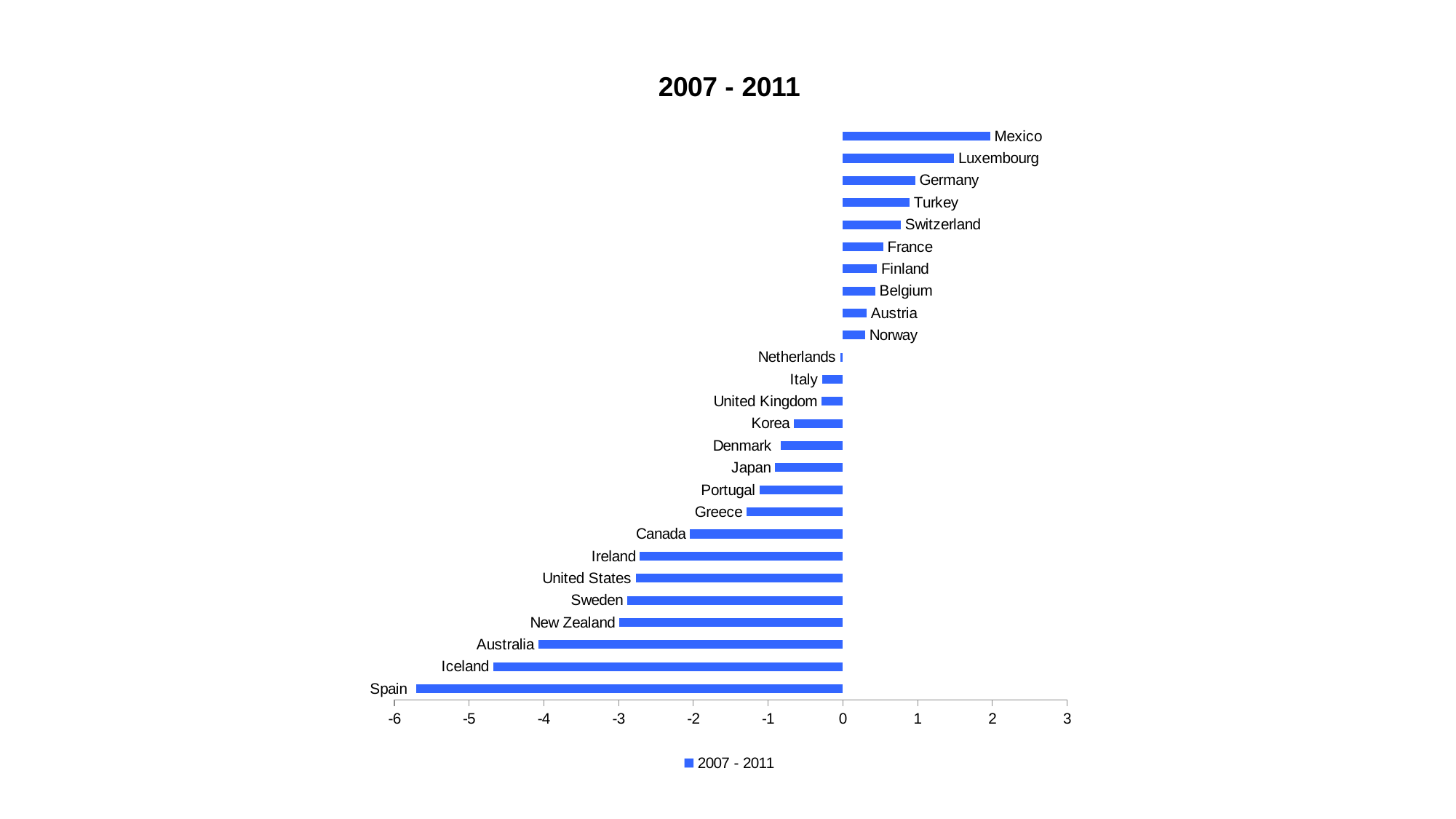
How many series does the legend list? 1 Which has the larger value, Mexico or Luxembourg? Mexico Is the value for Switzerland greater or less than 1? less Is the value for Spain greater or less than -5? less Is the value for Ireland greater or less than -2? less Which country has the highest value in the chart? Mexico Which country has the lowest value in the chart? Spain How many countries are plotted in the chart? 26 What kind of chart is shown on the slide? bar chart What is the title of the chart? 2007 - 2011